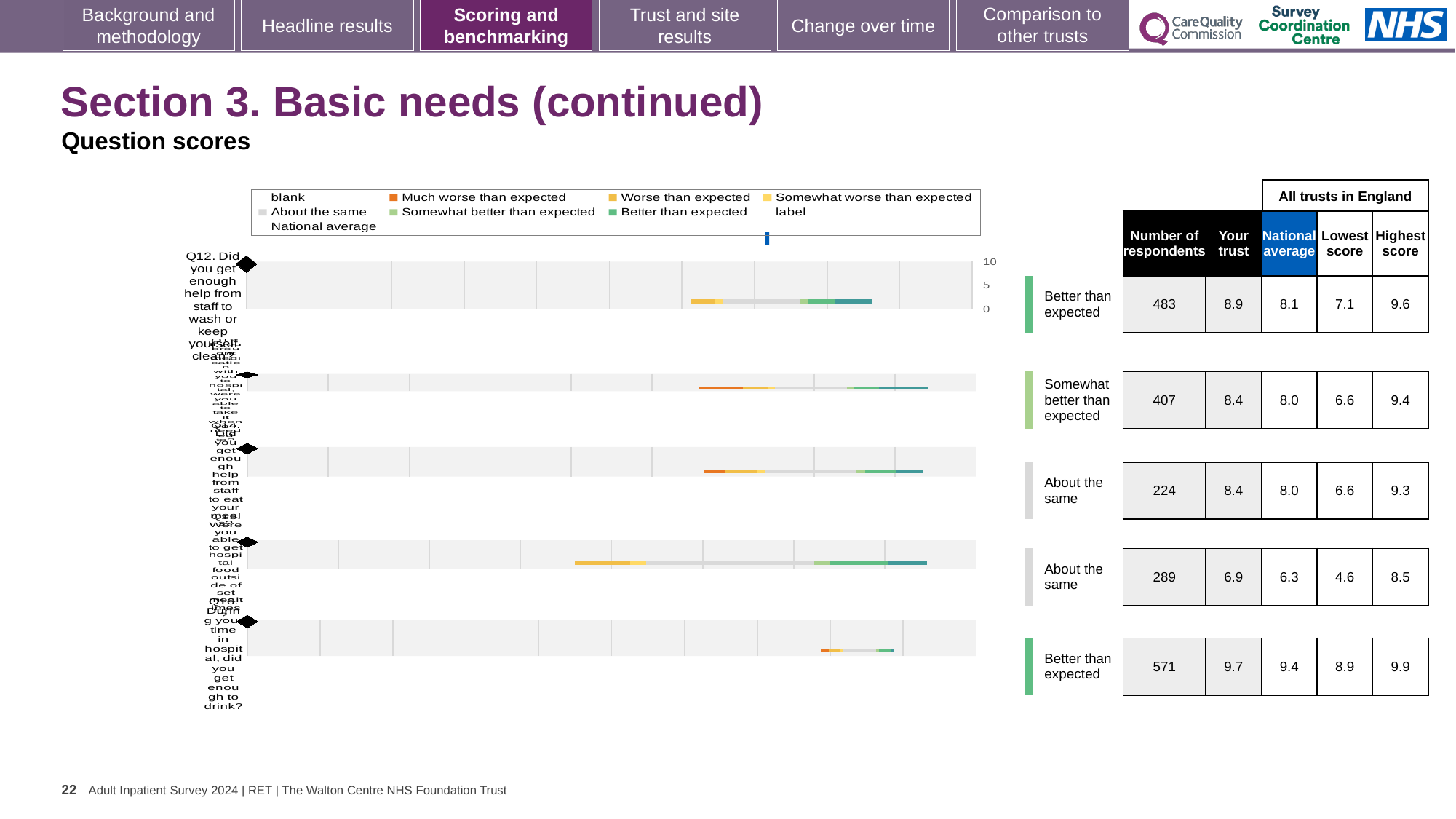
According to the table beside the chart, what is the 'Your trust' score for the first bar (Q12, help from staff to wash or keep yourself clean)? 8.9 According to the table beside the chart, is the 'Your trust' score for the last bar (enough to drink) larger or smaller than the national average? larger According to the table beside the chart, which bar has the lowest 'Your trust' score? the fourth bar (hospital food outside of set meal times), 6.9 According to the table beside the chart, what is the number of respondents for the last bar (enough to drink)? 571 According to the table beside the chart, what is the difference between the 'Your trust' score and the national average for the first bar (Q12)? 0.8 What is the highest value shown on the chart's axis? 10 In the chart legend, what colour represents 'Much worse than expected'? orange What kind of chart is shown on the slide? bar chart According to the table beside the chart, what benchmark category is the first bar (Q12) given? Better than expected How many question bars are plotted in the chart? 5 According to the table beside the chart, which bar has the highest 'Your trust' score? the last bar (enough to drink), 9.7